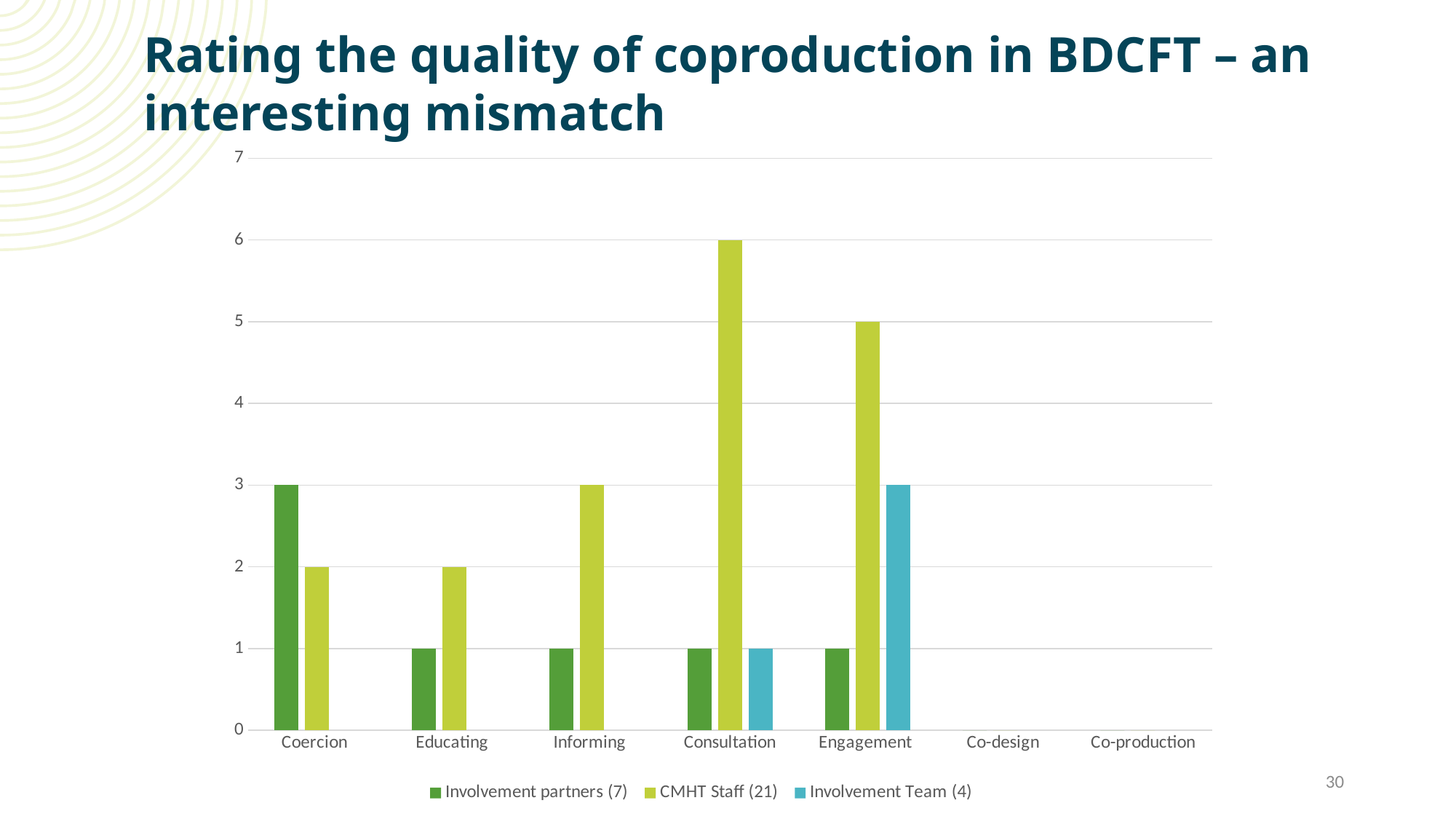
What is the difference between the CMHT Staff (21) values for Consultation and Engagement? 1 What is the value for CMHT Staff (21) in the Consultation category? 6 What is the value for Involvement partners (7) in the Coercion category? 3 How many categories are shown on the x axis? 7 What is the value for Involvement Team (4) in the Engagement category? 3 Is the value for CMHT Staff (21) in the Engagement category greater or less than 4? greater Which series is shown in blue in the legend? Involvement Team (4) What kind of chart is shown on the slide? Bar chart Which category has the highest value for CMHT Staff (21)? Consultation How many series does the legend list? 3 Which category has the highest value for Involvement partners (7)? Coercion In the Informing category, which is larger: the value for Involvement partners (7) or for CMHT Staff (21)? CMHT Staff (21)